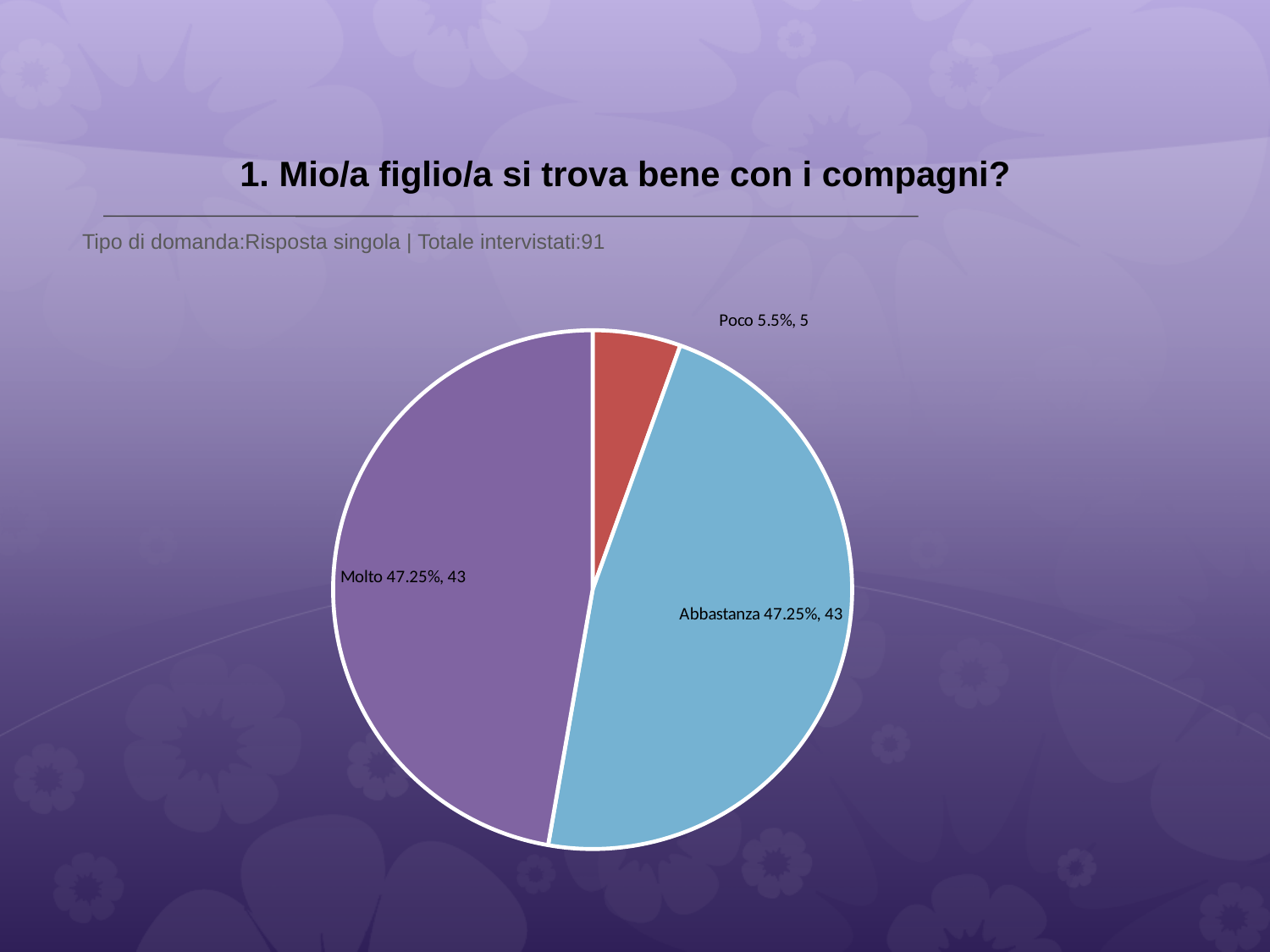
How many slices does the pie chart have? 3 What percentage share does the 'Poco' slice have? 5.5% Which slice is the smallest? Poco What percentage share does the 'Abbastanza' slice have? 47.25% What is the title of the chart on the slide? 1. Mio/a figlio/a si trova bene con i compagni? What is the total number of respondents shown on the slide? 91 What is the count for the 'Poco' slice? 5 What kind of chart is shown on the slide? pie chart Which is larger, the 'Abbastanza' slice or the 'Poco' slice? Abbastanza What is the difference in count between 'Molto' and 'Poco'? 38 What colour is the 'Poco' slice? red What is the count for the 'Molto' slice? 43